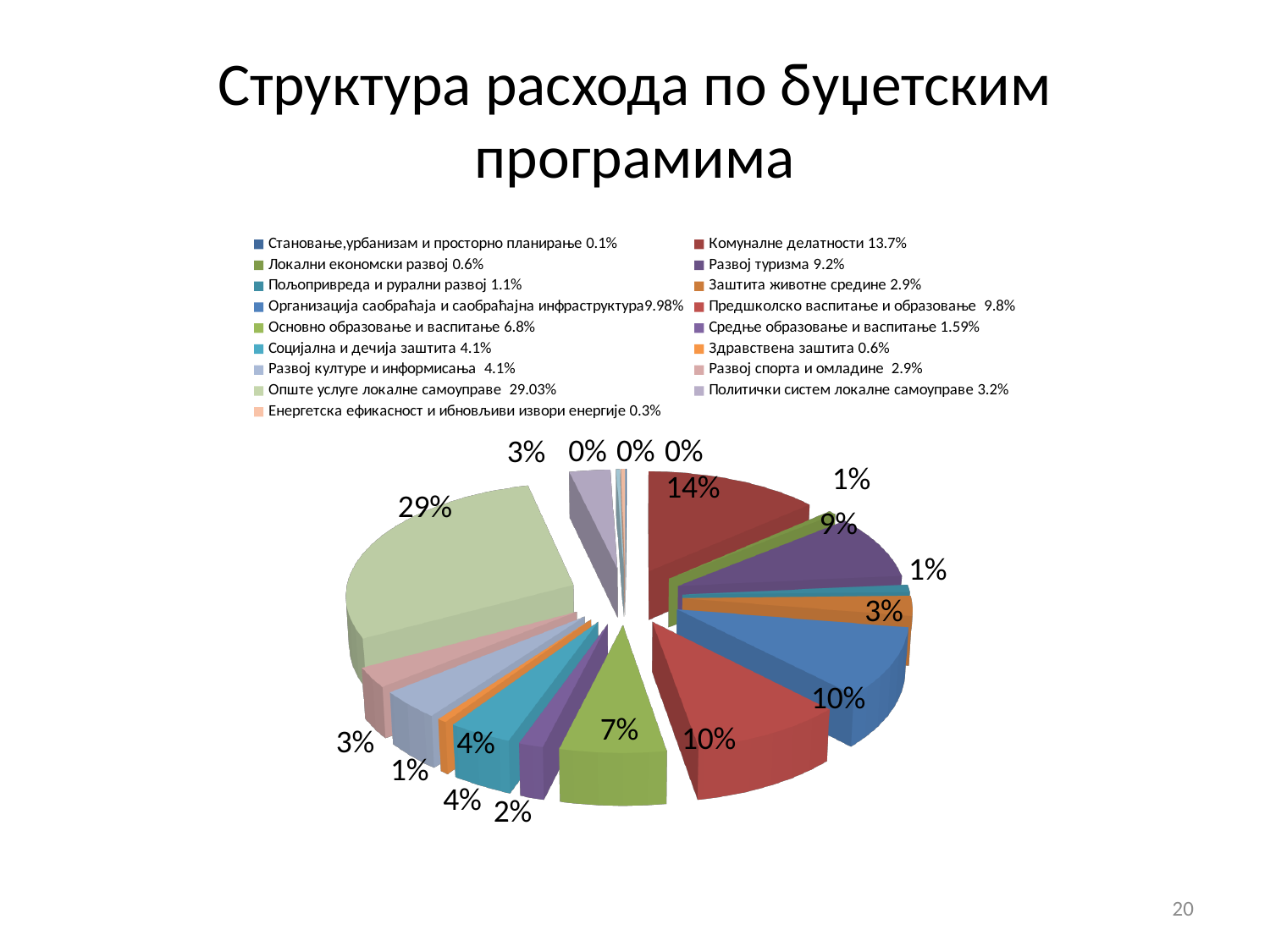
What is the title of the chart on the slide? Структура расхода по буџетским програмима How many budget programmes are listed in the legend? 17 According to the legend, what share does Развој туризма have? 9.2% Which has a larger share: Предшколско васпитање и образовање or Развој туризма? Предшколско васпитање и образовање Which budget programme has the largest share of expenditure in the pie chart? Опште услуге локалне самоуправе According to the legend, what share does Комуналне делатности have? 13.7% According to the legend, what share does Опште услуге локалне самоуправе have? 29.03% What is the difference in share between Комуналне делатности (13.7%) and Развој туризма (9.2%)? 4.5% According to the legend, what share does Становање,урбанизам и просторно планирање have? 0.1% What percentage is shown on the largest slice of the pie chart? 29% What kind of chart is shown on the slide? pie chart Which has a larger share: Основно образовање и васпитање or Социјална и дечија заштита? Основно образовање и васпитање